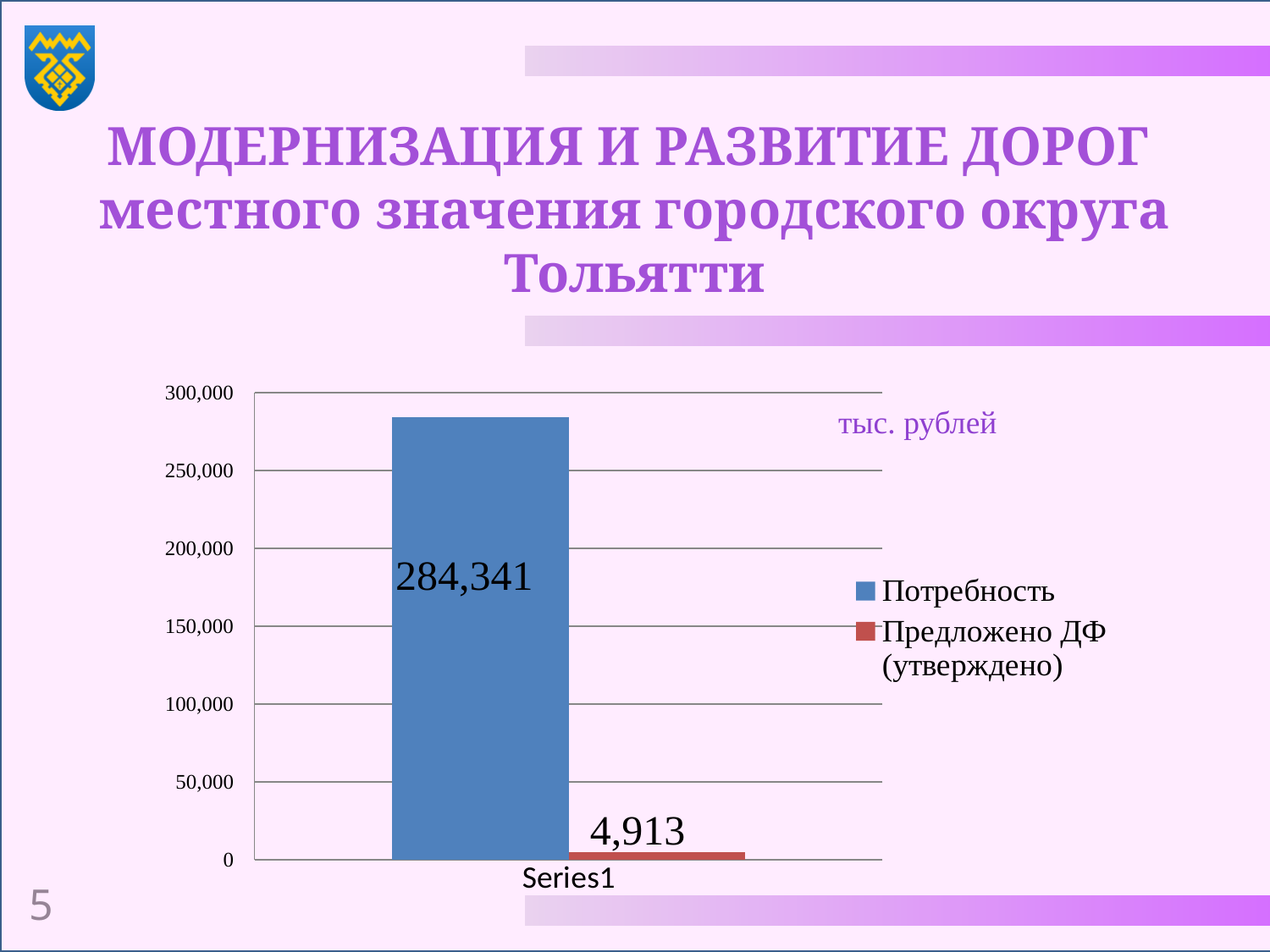
Is the value for Предложено ДФ (утверждено) greater or less than 50,000? less Is the value for Потребность greater or less than 250,000? greater How many series does the legend list? 2 What is the highest value shown on the vertical axis? 300,000 Which series has the lowest value? Предложено ДФ (утверждено) Which series has the higher value, Потребность or Предложено ДФ (утверждено)? Потребность What unit is indicated for the chart values? тыс. рублей What is the category label shown on the x axis? Series1 What kind of chart is shown on the slide? bar chart What is the value for Потребность? 284,341 What is the difference between the Потребность value and the Предложено ДФ (утверждено) value? 279,428 What is the value for Предложено ДФ (утверждено)? 4,913